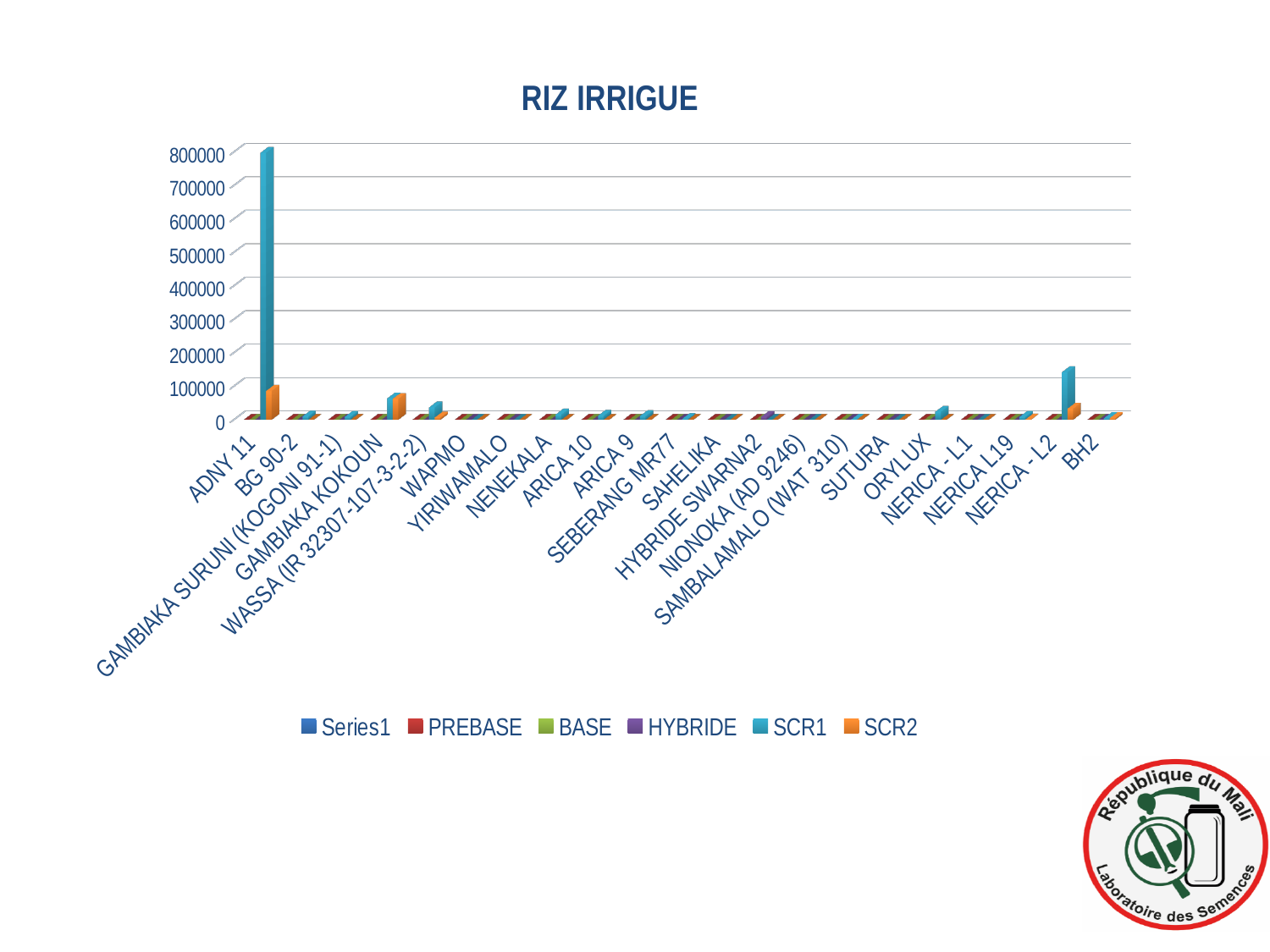
Which category has the highest SCR1 value? ADNY 11 Is the SCR1 value for ADNY 11 greater or less than 700000? greater How many series does the legend list? 6 How many categories are shown on the x axis? 21 Is the SCR2 value for ADNY 11 greater or less than 100000? less Is the SCR1 value for GAMBIAKA KOKOUN greater or less than 100000? less What is the title of the chart? RIZ IRRIGUE Which has the larger SCR1 value, ADNY 11 or NERICA - L2? ADNY 11 Which legend entry is shown in orange? SCR2 What kind of chart is shown on the slide? bar chart Which has the larger SCR1 value, NERICA - L2 or GAMBIAKA KOKOUN? NERICA - L2